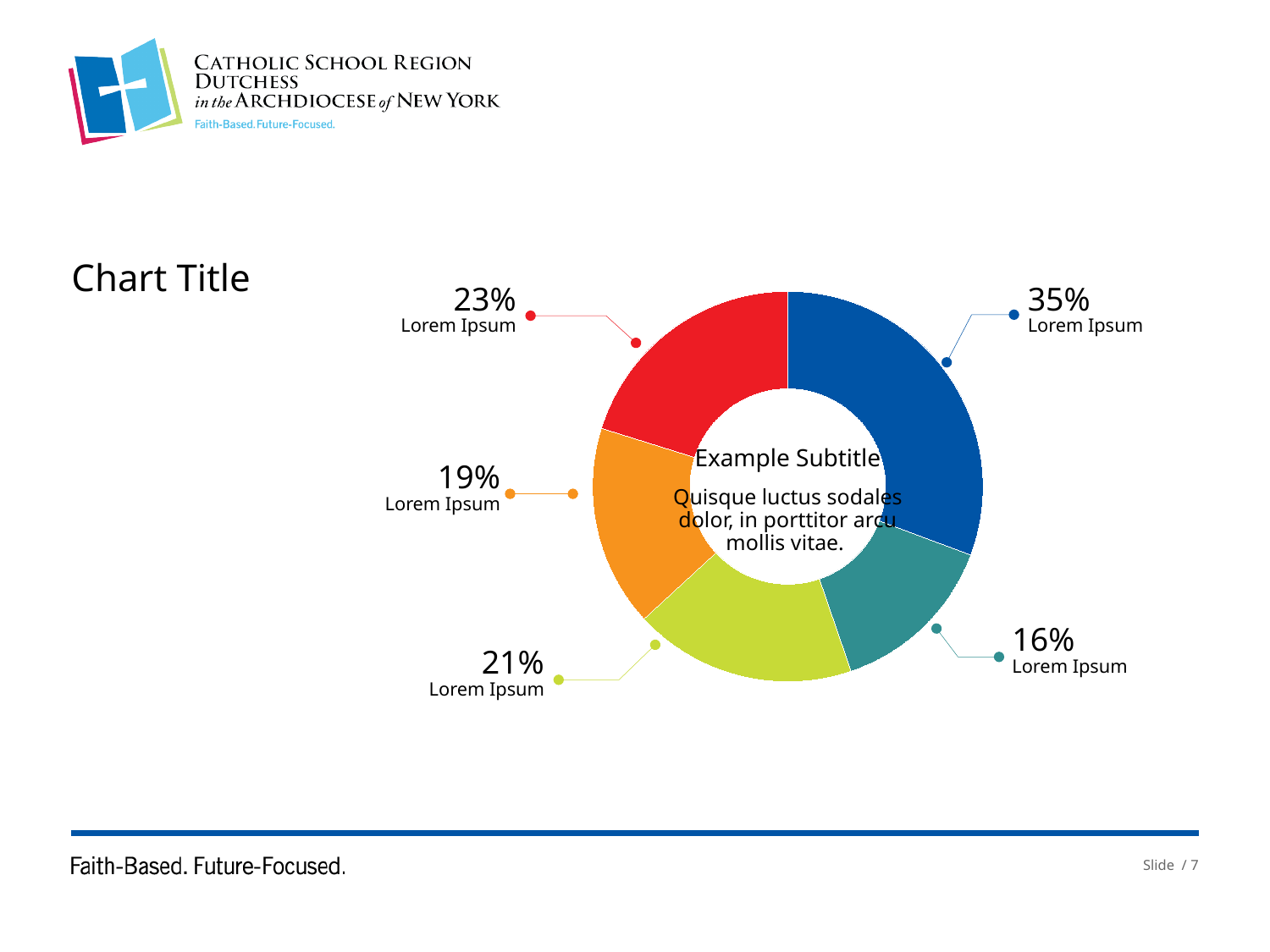
Which is larger, the red slice or the green slice? The red slice (23%) Which slice of the donut chart has the largest percentage? The dark blue slice (35%) What is the title of the chart? Chart Title What is the difference between the largest slice (35%) and the smallest slice (16%)? 19% What percentage is shown for the orange slice? 19% What percentage is shown for the teal slice? 16% How many slices does the donut chart have? 5 Which slice of the donut chart has the smallest percentage? The teal slice (16%) What percentage is shown for the red slice? 23% What percentage is shown for the green slice? 21% What percentage is shown for the dark blue slice? 35% What kind of chart is shown on the slide? Donut (pie) chart